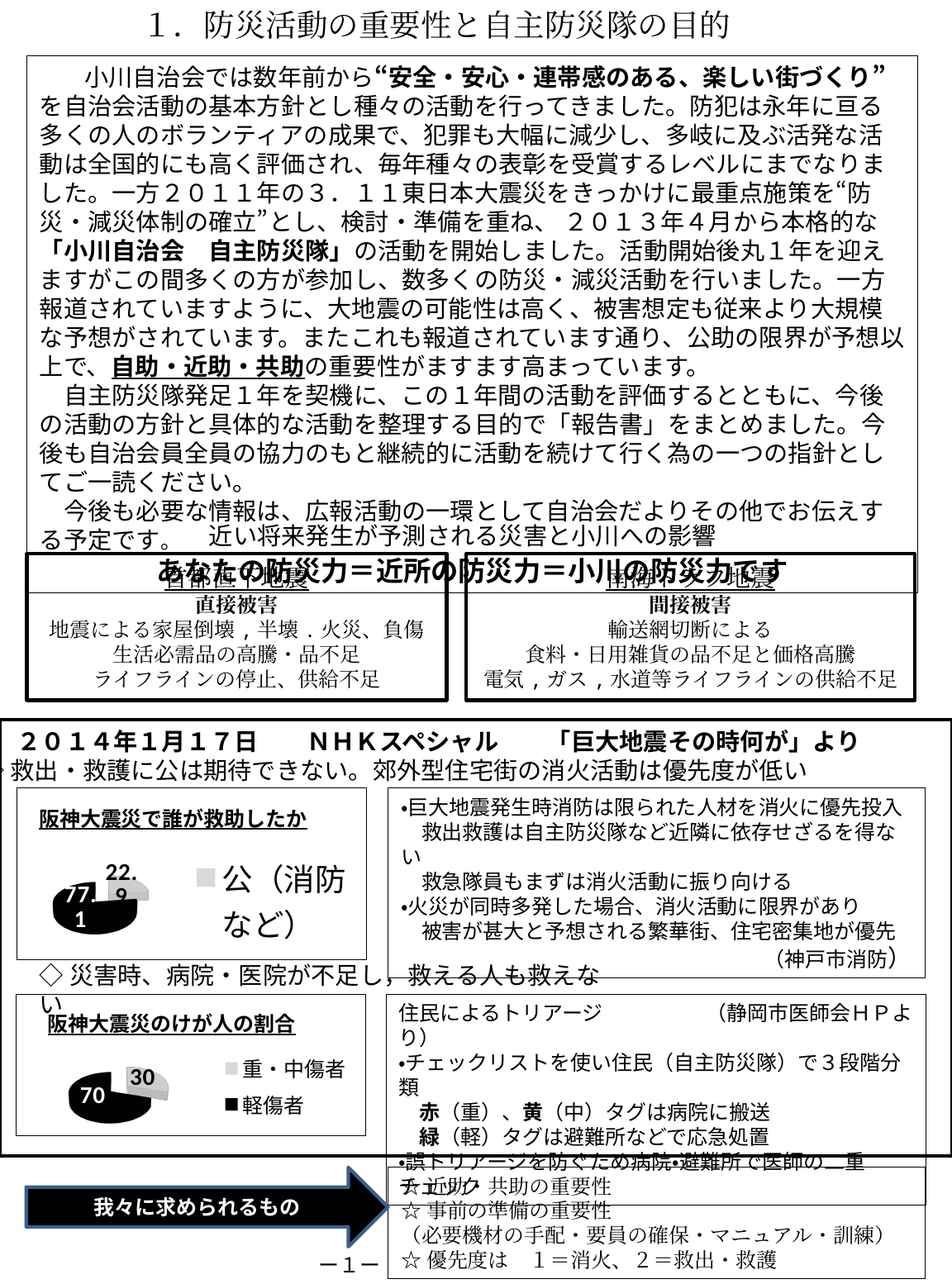
In the chart titled 阪神大震災のけが人の割合, what is the difference between the values for 軽傷者 and 重・中傷者? 40 In the chart titled 阪神大震災のけが人の割合, what is the value for 重・中傷者? 30 In the chart titled 阪神大震災のけが人の割合, which category is shown in black? 軽傷者 In the chart titled 阪神大震災のけが人の割合, which category has the larger share: 重・中傷者 or 軽傷者? 軽傷者 What kind of chart is the chart titled 阪神大震災で誰が救助したか? pie chart In the chart titled 阪神大震災で誰が救助したか, what is the value for 公（消防など）? 22.9 In the chart titled 阪神大震災で誰が救助したか, what is the value of the largest slice? 77.1 What kind of chart is the chart titled 阪神大震災のけが人の割合? pie chart In the chart titled 阪神大震災のけが人の割合, what is the value for 軽傷者? 70 In the chart titled 阪神大震災のけが人の割合, how many entries does the legend list? 2 In the chart titled 阪神大震災で誰が救助したか, how many slices does the pie have? 2 In the chart titled 阪神大震災で誰が救助したか, what is the difference between the two slice values? 54.2